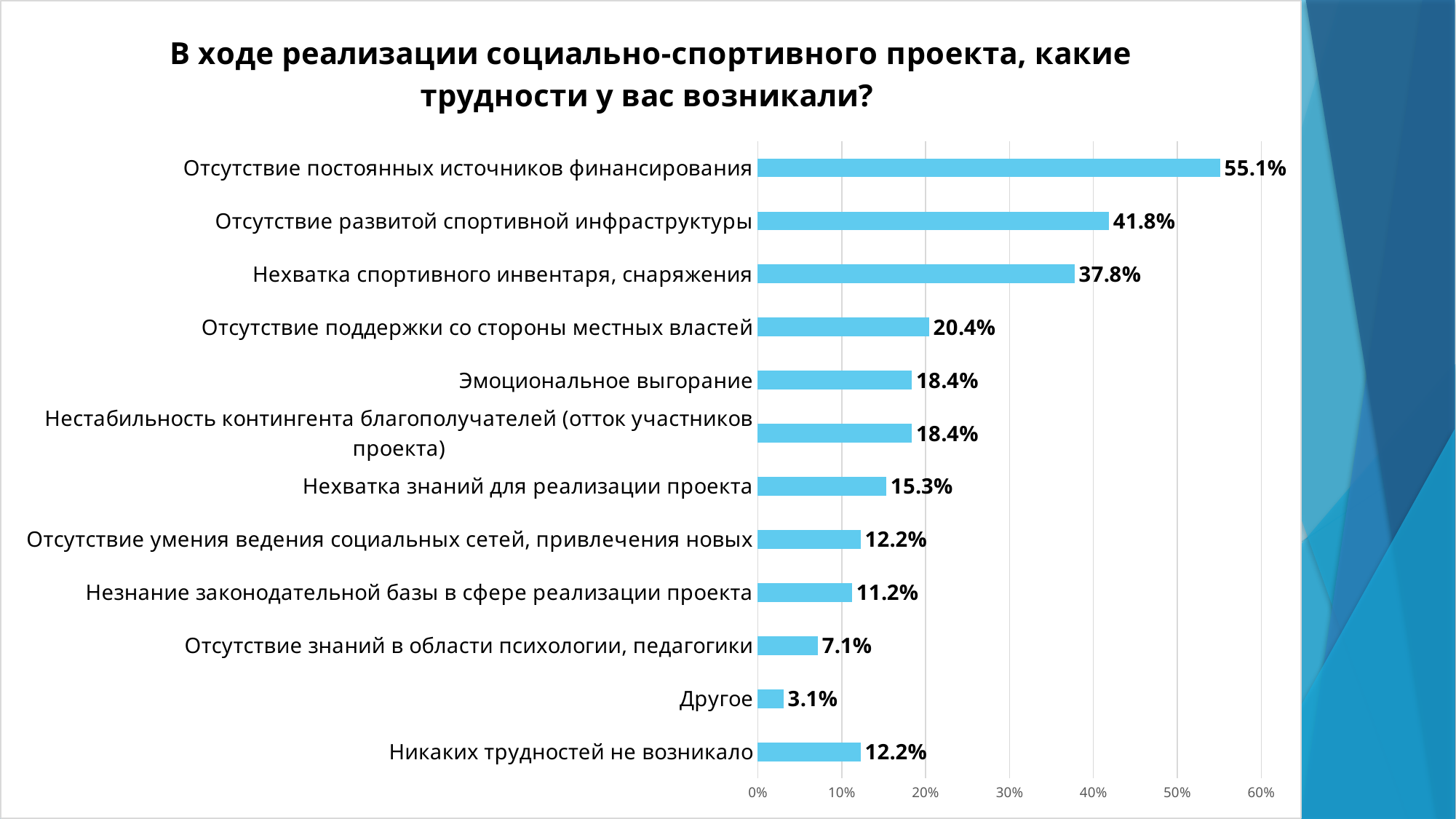
What kind of chart is shown on the slide? bar chart Which category has the lowest value? Другое What is the difference between «Отсутствие развитой спортивной инфраструктуры» and «Нехватка спортивного инвентаря, снаряжения»? 4.0% How many categories are shown in the chart? 12 Is the value for «Отсутствие знаний в области психологии, педагогики» greater or less than 10%? less What is the value for «Отсутствие постоянных источников финансирования»? 55.1% What is the value for «Никаких трудностей не возникало»? 12.2% Which category has the highest value? Отсутствие постоянных источников финансирования What is the title of the chart? В ходе реализации социально-спортивного проекта, какие трудности у вас возникали? What is the value for «Другое»? 3.1% What is the value for «Эмоциональное выгорание»? 18.4% Which is larger: «Отсутствие поддержки со стороны местных властей» or «Нехватка знаний для реализации проекта»? Отсутствие поддержки со стороны местных властей